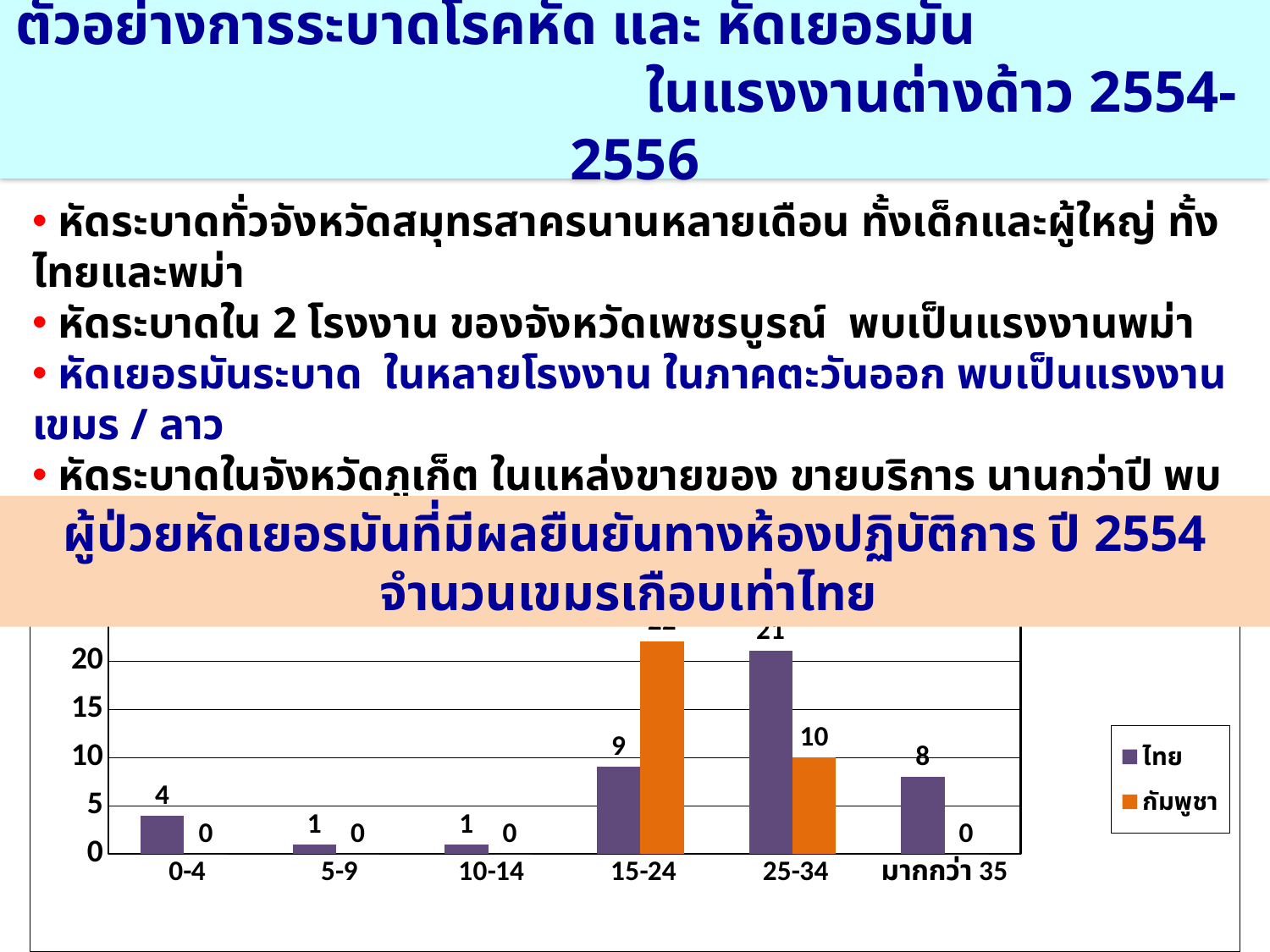
What is the difference between the ไทย and กัมพูชา values in the 25-34 age group? 11 Is the value for กัมพูชา in the 15-24 age group greater or less than 20? greater What is the value for กัมพูชา in the มากกว่า 35 age group? 0 What kind of chart is shown on the slide? bar chart How many series does the legend list? 2 How many age-group categories are shown on the x axis? 6 In the 15-24 age group, which series has the larger value, ไทย or กัมพูชา? กัมพูชา Which age group has the highest value for ไทย? 25-34 What is the value for กัมพูชา in the 25-34 age group? 10 What is the value for ไทย in the 0-4 age group? 4 What is the value for ไทย in the มากกว่า 35 age group? 8 What is the value for ไทย in the 25-34 age group? 21